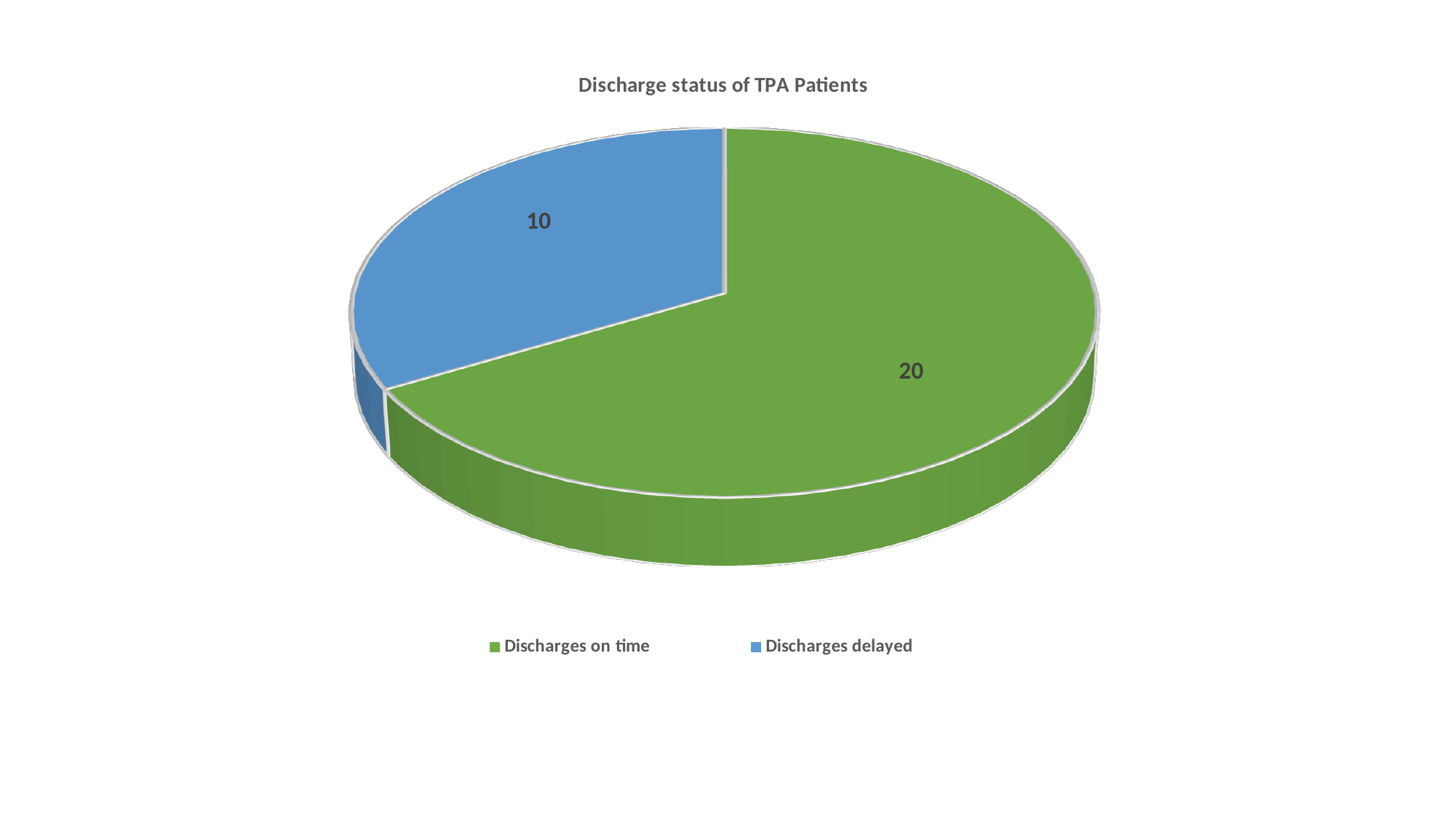
What colour is the Discharges delayed slice? Blue What share of the pie does Discharges delayed represent? One third What kind of chart is shown on the slide? Pie chart What is the total of all slices in the pie chart? 30 What is the title of the chart? Discharge status of TPA Patients What is the difference between Discharges on time and Discharges delayed? 10 Which category has the smallest slice of the pie? Discharges delayed Which category has the largest slice of the pie? Discharges on time Which is larger, Discharges on time or Discharges delayed? Discharges on time What is the value for Discharges delayed? 10 What is the value for Discharges on time? 20 How many slices does the pie chart have? 2